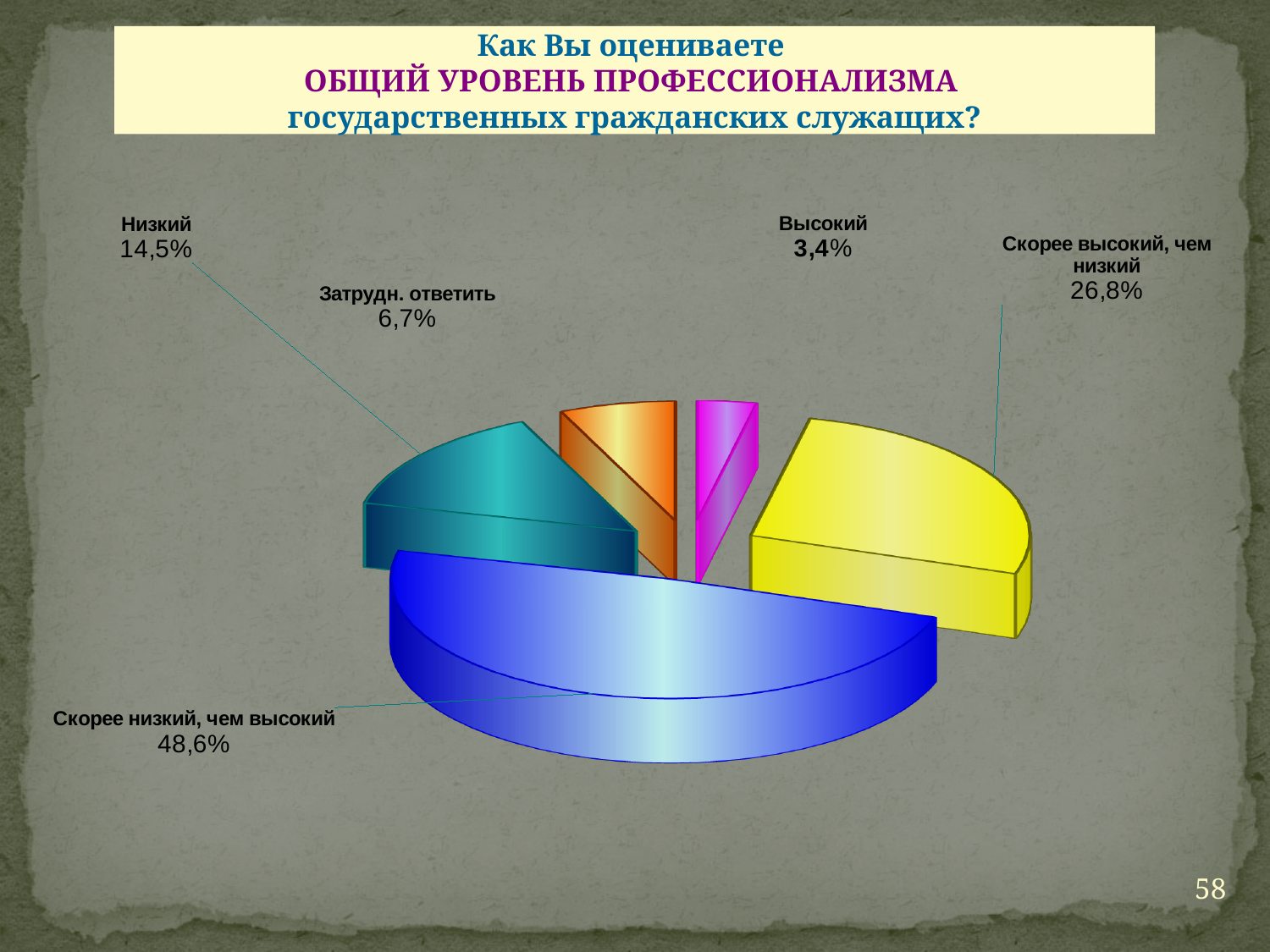
Which answer option has the largest share of the pie? Скорее низкий, чем высокий What type of chart is shown on the slide? Pie chart What colour is the slice for "Скорее высокий, чем низкий"? Yellow Which answer option has the smallest share of the pie? Высокий What percentage of respondents answered "Скорее низкий, чем высокий"? 48,6% What percentage of respondents answered "Затрудн. ответить"? 6,7% What percentage of respondents answered "Высокий"? 3,4% How many slices does the pie chart have? 5 Which is larger: the share for "Низкий" or the share for "Затрудн. ответить"? Низкий What is the difference in percentage points between "Скорее низкий, чем высокий" and "Скорее высокий, чем низкий"? 21,8 What percentage of respondents answered "Низкий"? 14,5% What percentage of respondents answered "Скорее высокий, чем низкий"? 26,8%